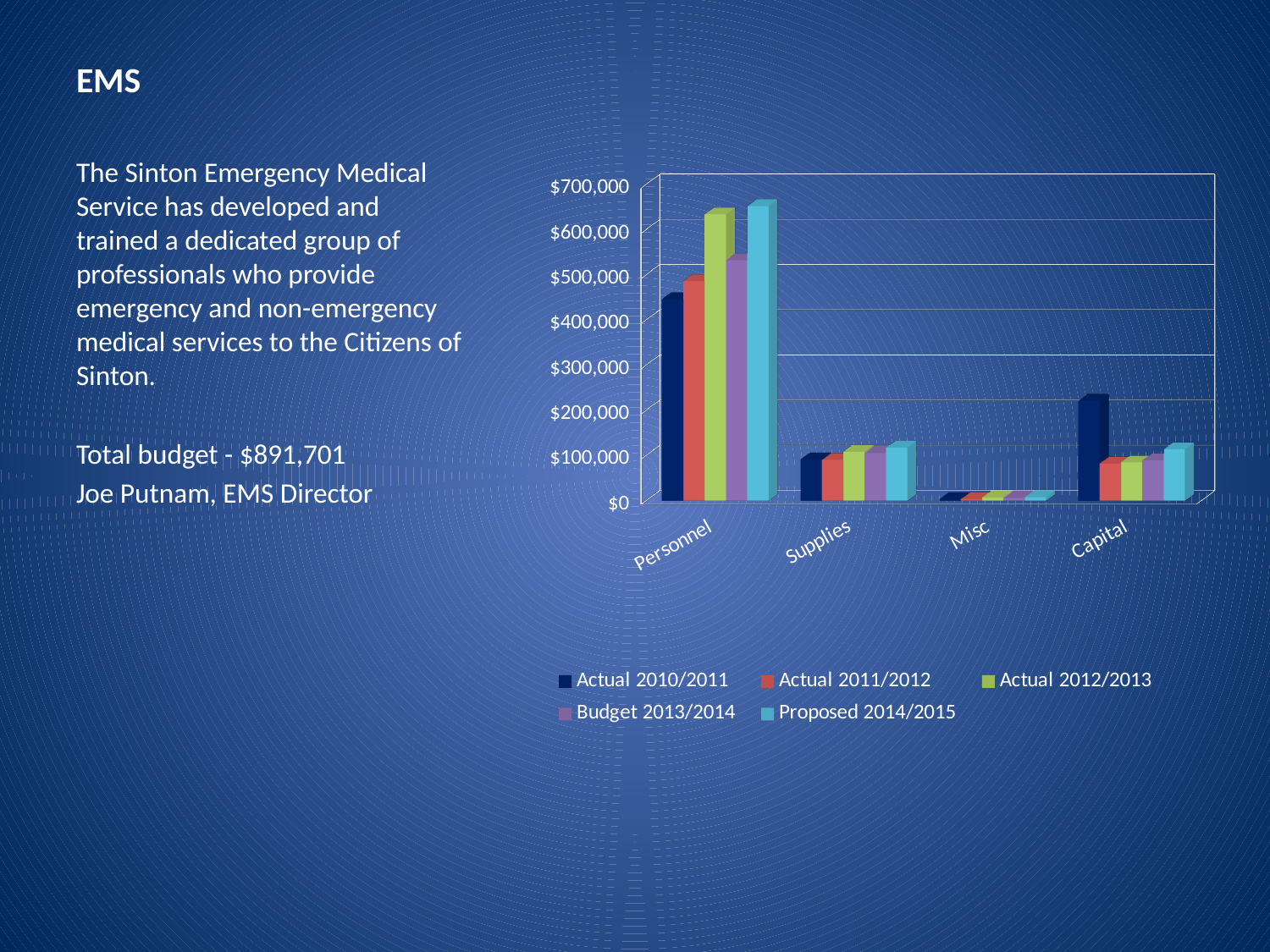
Which series is shown in light blue in the chart's legend? Proposed 2014/2015 Is the Actual 2010/2011 value for Personnel greater or less than $500,000? less Which category has the highest values in the chart? Personnel Which category has the lowest values in the chart? Misc What kind of chart is shown on the slide? bar chart Is the Proposed 2014/2015 value for Personnel greater or less than $600,000? greater For Personnel, which is larger: Actual 2012/2013 or Actual 2011/2012? Actual 2012/2013 How many categories are shown on the x axis of the chart? 4 How many series does the chart's legend list? 5 Within the Capital category, which series has the highest value? Actual 2010/2011 Is the Actual 2010/2011 value for Capital greater or less than $100,000? greater